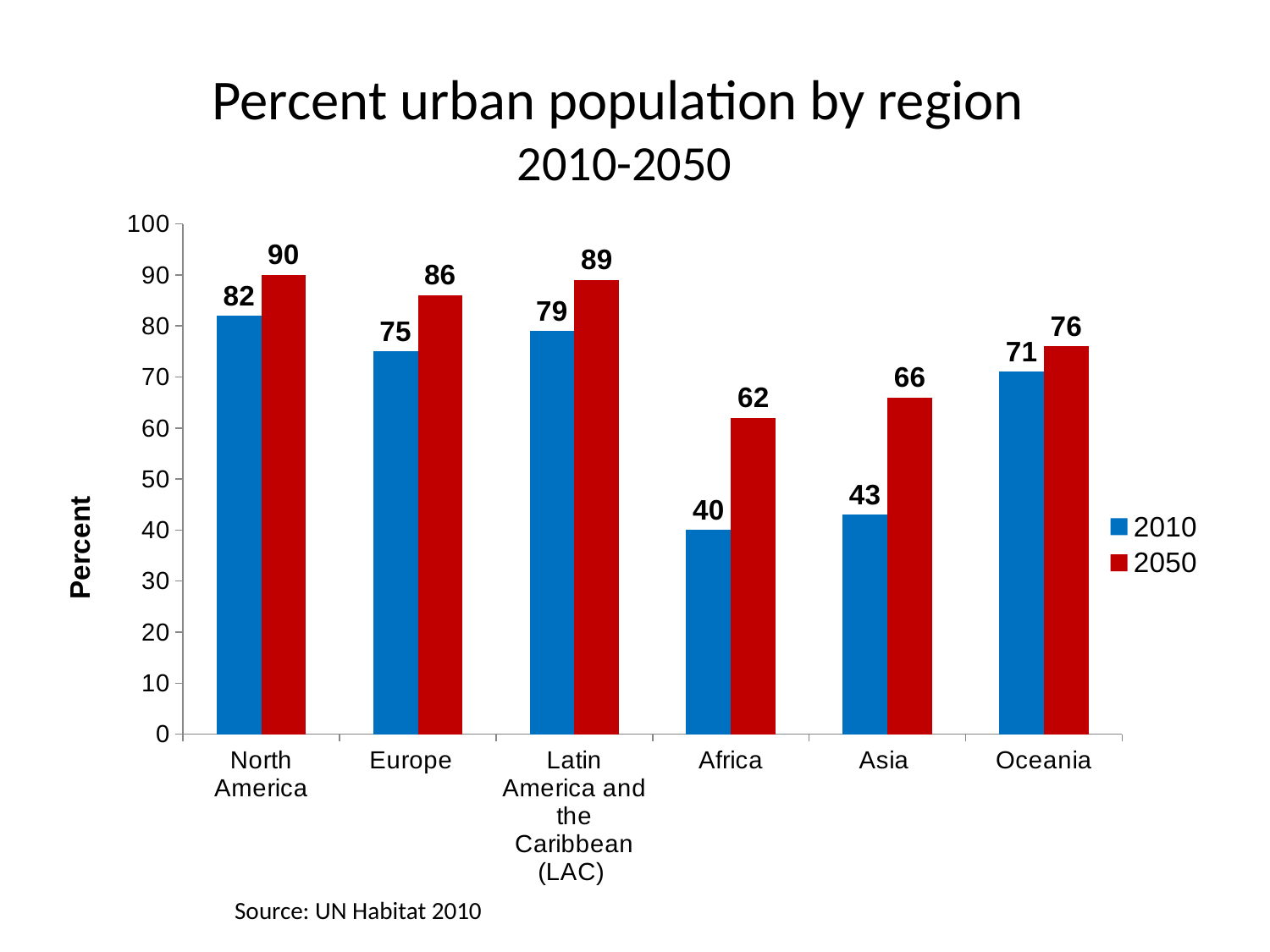
How many regions are shown on the x axis? 6 What is the source cited below the chart? UN Habitat 2010 Is the 2010 value for Africa greater or less than 50? less What is the 2050 percent urban population for Africa? 62 What is the 2050 value for Latin America and the Caribbean (LAC)? 89 What kind of chart is shown on the slide? bar chart How many series does the legend list? 2 Which region has the highest 2050 percent urban population? North America What is the 2010 percent urban population for North America? 82 Which is larger: the 2010 value for Europe or the 2010 value for Oceania? Europe What is the difference between the 2050 and 2010 values for Asia? 23 Which region has the lowest 2010 percent urban population? Africa